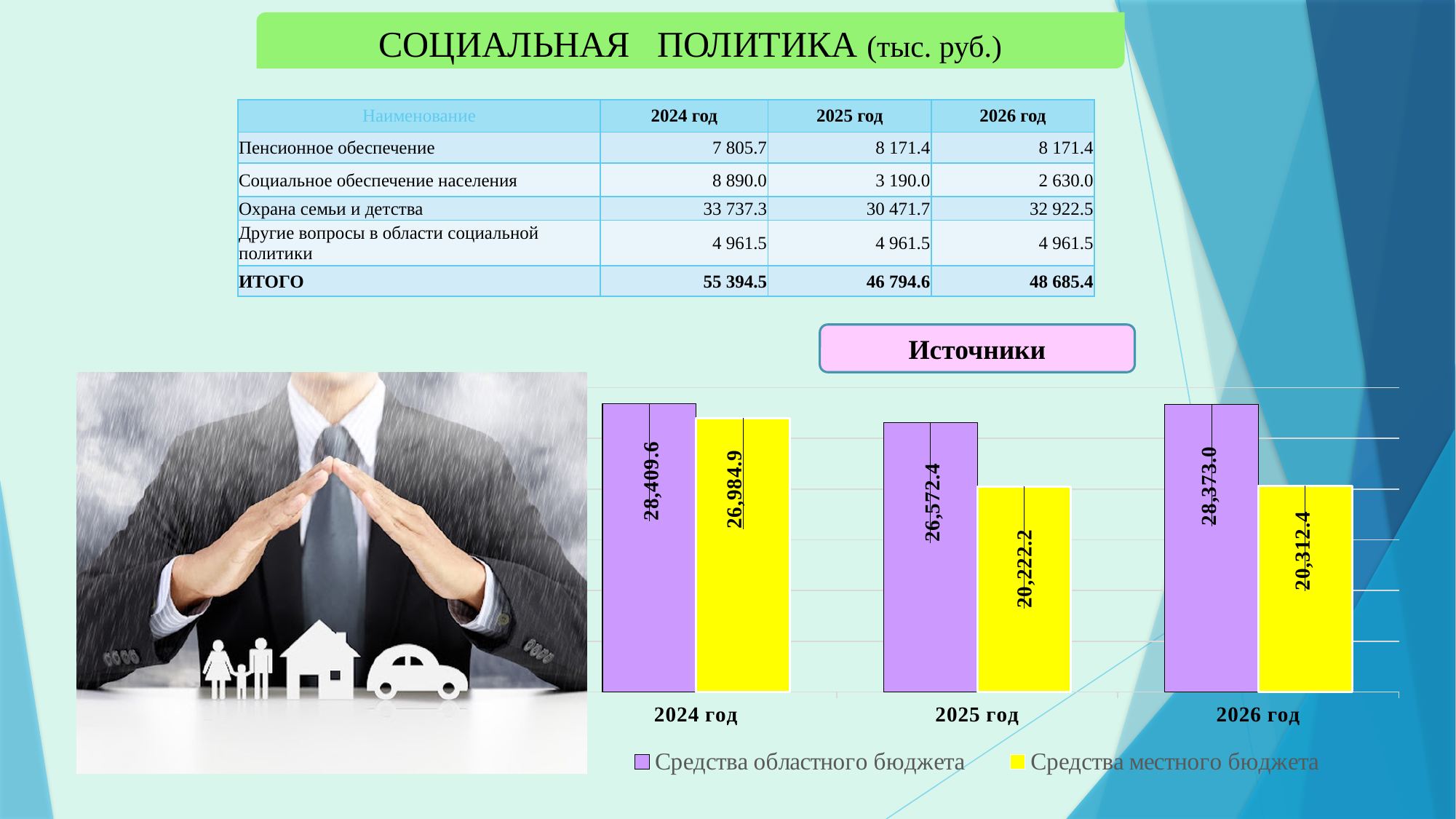
What kind of chart is shown under the heading Источники? bar chart What is the value for Средства местного бюджета in 2026 год? 20,312.4 In which year is the value for Средства областного бюджета lowest? 2025 год Which is larger in 2024 год: Средства областного бюджета or Средства местного бюджета? Средства областного бюджета What is the value for Средства областного бюджета in 2025 год? 26,572.4 What is the value for Средства местного бюджета in 2025 год? 20,222.2 How many series does the chart legend list? 2 How many years are shown on the x axis of the chart? 3 What is the difference between Средства областного бюджета and Средства местного бюджета in 2025 год? 6,350.2 What is the difference between Средства областного бюджета and Средства местного бюджета in 2026 год? 8,060.6 What is the value for Средства областного бюджета in 2024 год? 28,409.6 In which year is the value for Средства местного бюджета highest? 2024 год